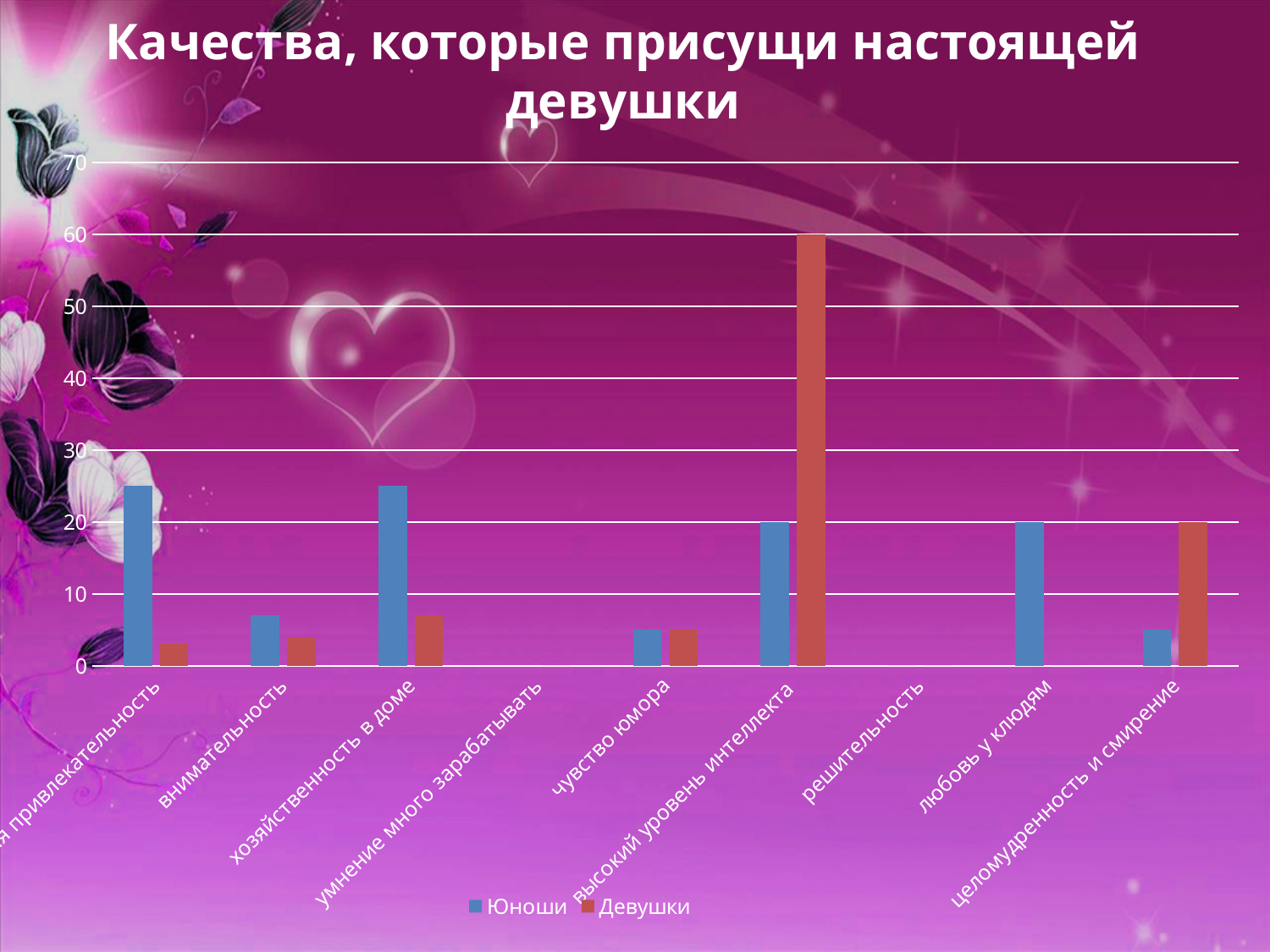
In the category высокий уровень интеллекта, what is the difference between the Девушки and Юноши values? 40 What is the value for Юноши in the category любовь у людям? 20 What is the value for Девушки in the category высокий уровень интеллекта? 60 In the category хозяйственность в доме, which series has the larger value, Юноши or Девушки? Юноши Which series is shown in blue in the legend? Юноши What is the value for Юноши in the category высокий уровень интеллекта? 20 What is the value for Девушки in the category целомудренность и смирение? 20 Is the value for Юноши in the category хозяйственность в доме greater or less than 20? greater What kind of chart is shown on the slide? bar chart Which category has the highest value for the Девушки series? высокий уровень интеллекта How many series does the legend list? 2 How many categories are shown on the x axis? 9